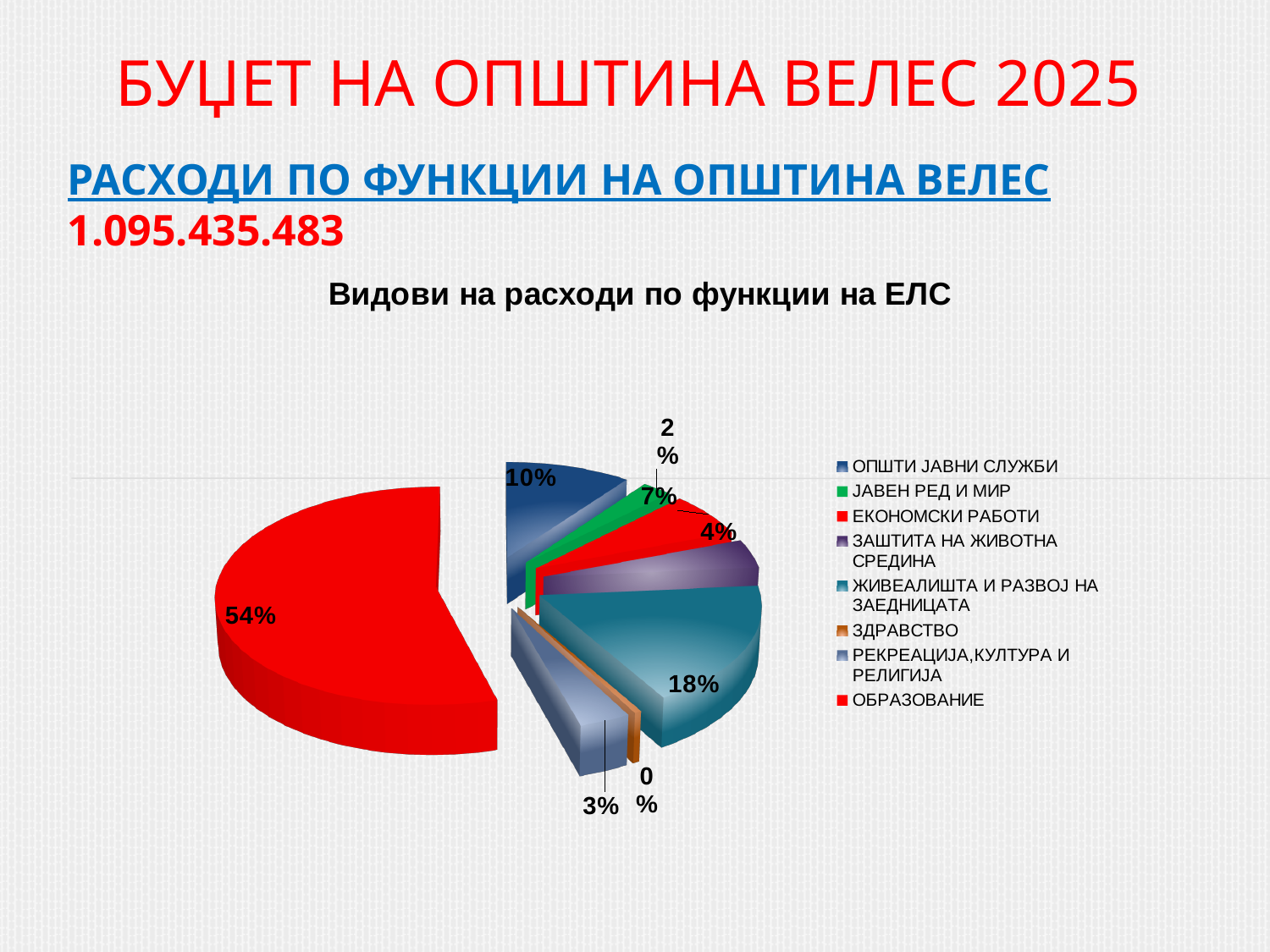
What share of the pie does ОБРАЗОВАНИЕ have? 54% What is the title of the chart? Видови на расходи по функции на ЕЛС What share of the pie does ЕКОНОМСКИ РАБОТИ have? 7% What share of the pie does ЗАШТИТА НА ЖИВОТНА СРЕДИНА have? 4% What share of the pie does ЗДРАВСТВО have? 0% What is the difference in percentage points between ОБРАЗОВАНИЕ and ЖИВЕАЛИШТА И РАЗВОЈ НА ЗАЕДНИЦАТА? 36 percentage points Which category has the smallest share of the pie? ЗДРАВСТВО What share of the pie does ОПШТИ ЈАВНИ СЛУЖБИ have? 10% How many categories does the legend list? 8 What share of the pie does ЖИВЕАЛИШТА И РАЗВОЈ НА ЗАЕДНИЦАТА have? 18% Which category has the largest share of the pie? ОБРАЗОВАНИЕ What kind of chart is shown on the slide? pie chart